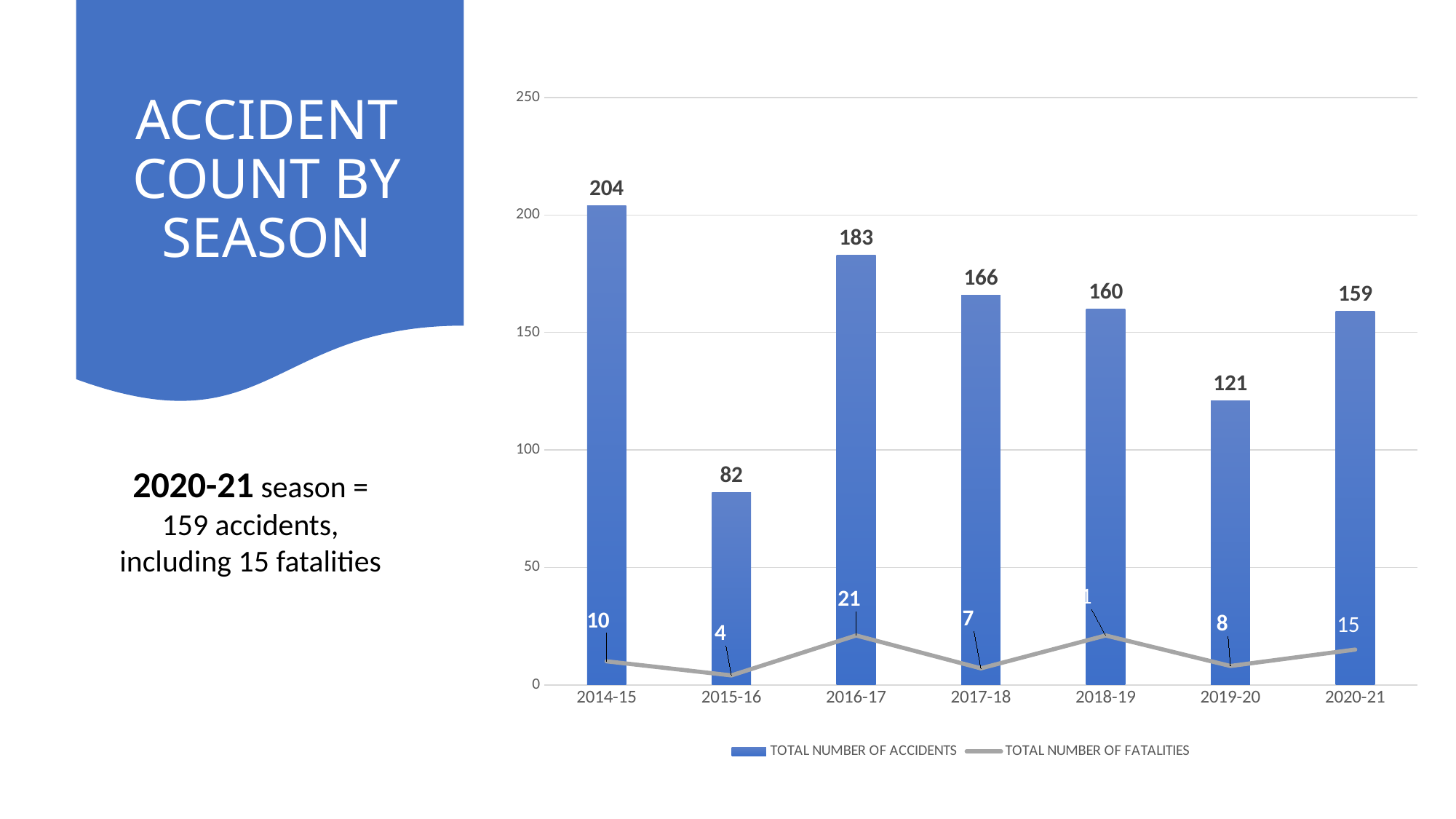
How many accidents were recorded in the 2014-15 season? 204 Which season has the highest total number of accidents? 2014-15 How many series does the chart legend list? 2 What kind of chart is used to show the total number of accidents? Bar chart Which series is drawn as a grey line in the chart? Total number of fatalities What is the difference in the number of accidents between the 2016-17 and 2017-18 seasons? 17 Which season had more accidents, 2018-19 or 2020-21? 2018-19 How many fatalities were recorded in the 2016-17 season? 21 What is the total number of accidents for the 2019-20 season? 121 How many seasons are shown on the x axis of the chart? 7 Which season has the lowest total number of accidents? 2015-16 Is the number of accidents in the 2015-16 season greater or less than 100? less